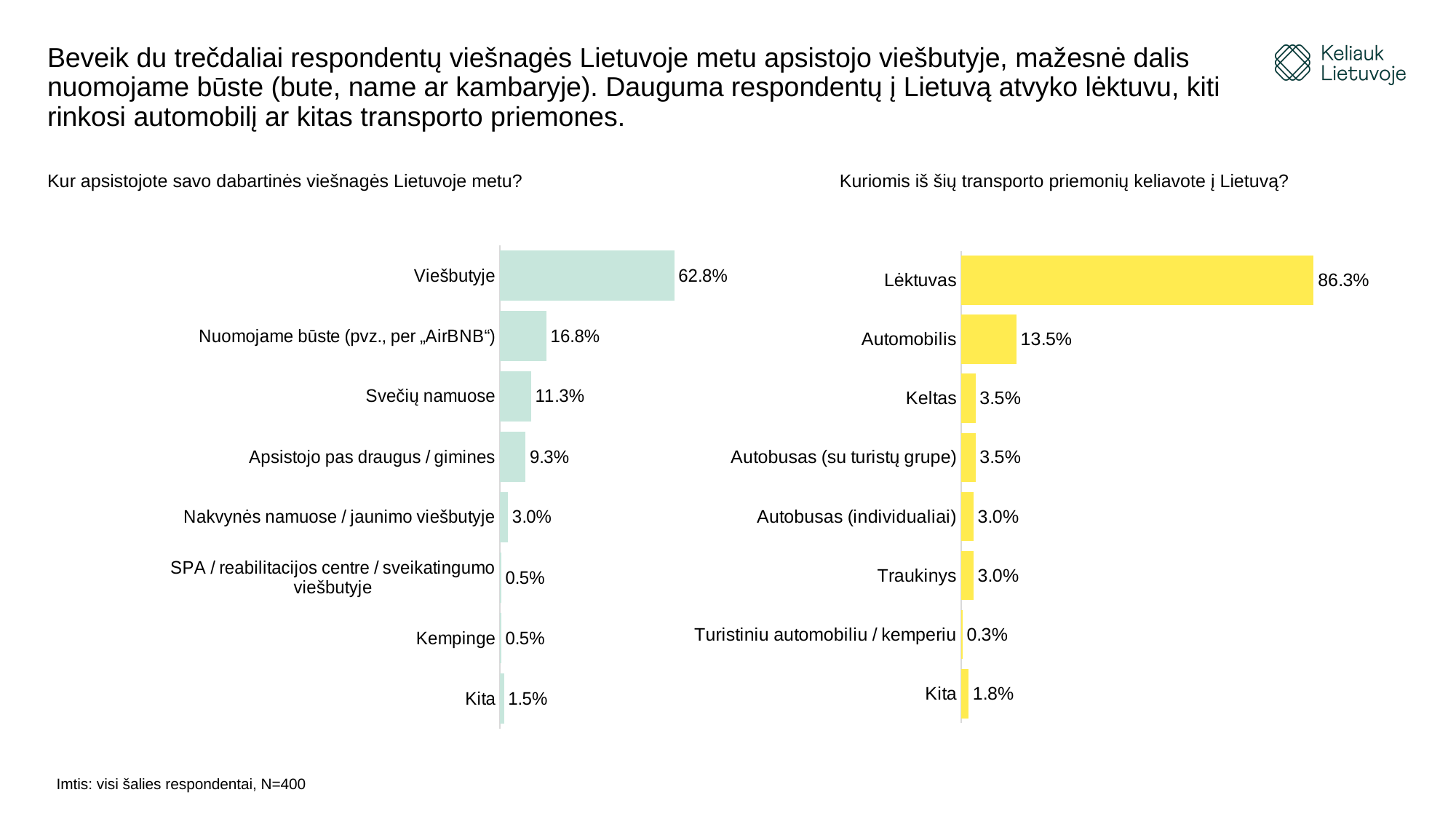
In the right chart (Kuriomis iš šių transporto priemonių keliavote į Lietuvą?), which category has the highest value? Lėktuvas What type of chart is the left chart (Kur apsistojote savo dabartinės viešnagės Lietuvoje metu?)? Bar chart In the right chart (Kuriomis iš šių transporto priemonių keliavote į Lietuvą?), what is the value for Automobilis? 13.5% In the right chart (Kuriomis iš šių transporto priemonių keliavote į Lietuvą?), what is the value for Turistiniu automobiliu / kemperiu? 0.3% In the left chart (Kur apsistojote savo dabartinės viešnagės Lietuvoje metu?), what is the difference between Viešbutyje and Nuomojame būste (pvz., per „AirBNB“)? 46.0% In the left chart (Kur apsistojote savo dabartinės viešnagės Lietuvoje metu?), which category has the highest value? Viešbutyje How many categories are shown in the right chart (Kuriomis iš šių transporto priemonių keliavote į Lietuvą?)? 8 In the right chart (Kuriomis iš šių transporto priemonių keliavote į Lietuvą?), what is the difference between Lėktuvas and Automobilis? 72.8% In the right chart (Kuriomis iš šių transporto priemonių keliavote į Lietuvą?), which category has the lowest value? Turistiniu automobiliu / kemperiu In the left chart (Kur apsistojote savo dabartinės viešnagės Lietuvoje metu?), which is larger: Apsistojo pas draugus / gimines or Nakvynės namuose / jaunimo viešbutyje? Apsistojo pas draugus / gimines In the left chart (Kur apsistojote savo dabartinės viešnagės Lietuvoje metu?), what is the value for Viešbutyje? 62.8% In the left chart (Kur apsistojote savo dabartinės viešnagės Lietuvoje metu?), what is the value for Svečių namuose? 11.3%